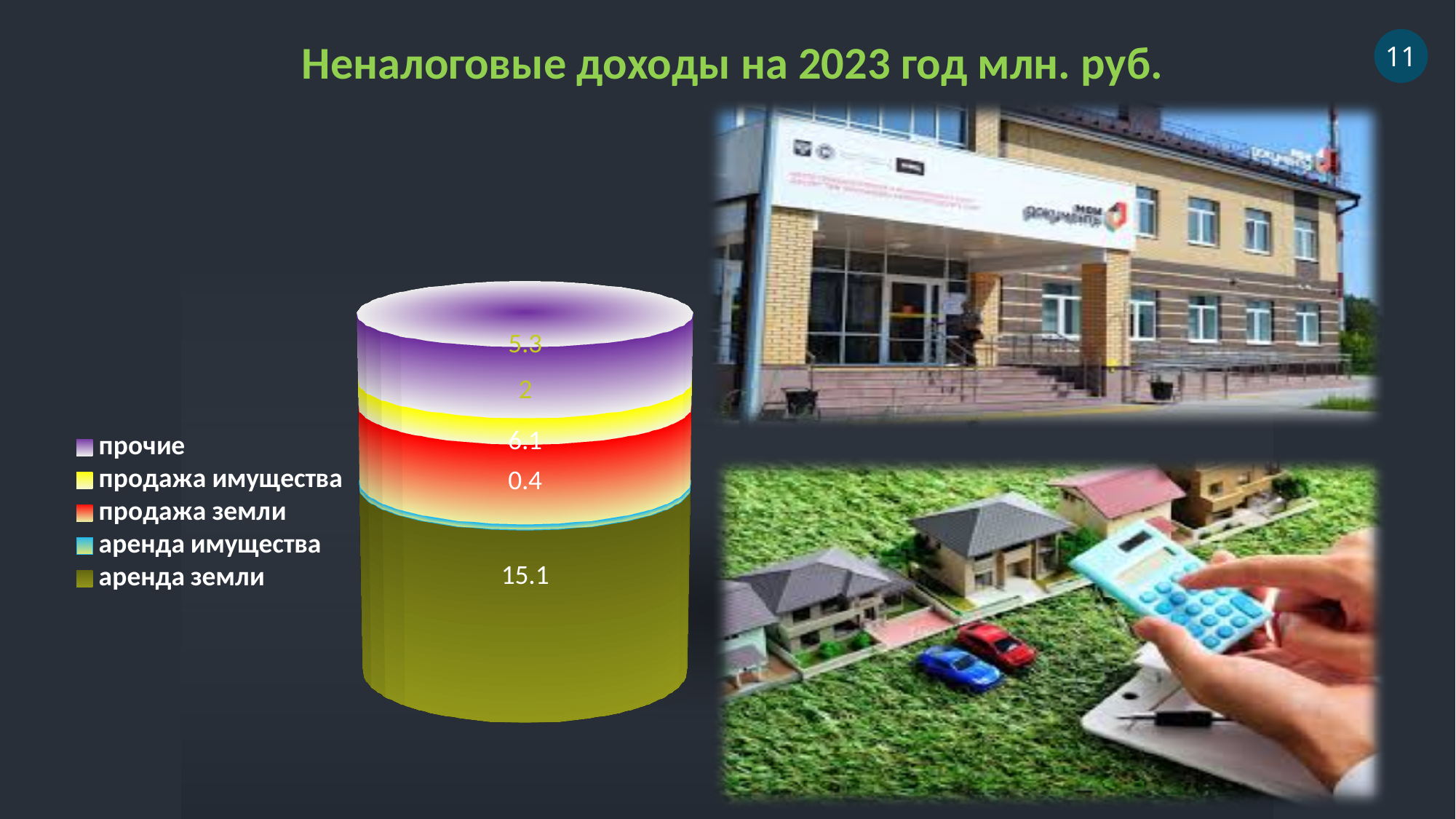
What is the value for продажа земли? 6.1 How many series does the legend list? 5 What is the title of the chart? Неналоговые доходы на 2023 год млн. руб. What is the value for прочие? 5.3 What is the value for продажа имущества? 2 Which is larger, прочие or продажа имущества? прочие What is the difference between аренда земли and продажа земли? 9 What is the value for аренда земли? 15.1 What is the total of the stacked bar? 28.9 Which category has the lowest value? аренда имущества Which category has the highest value? аренда земли What is the value for аренда имущества? 0.4